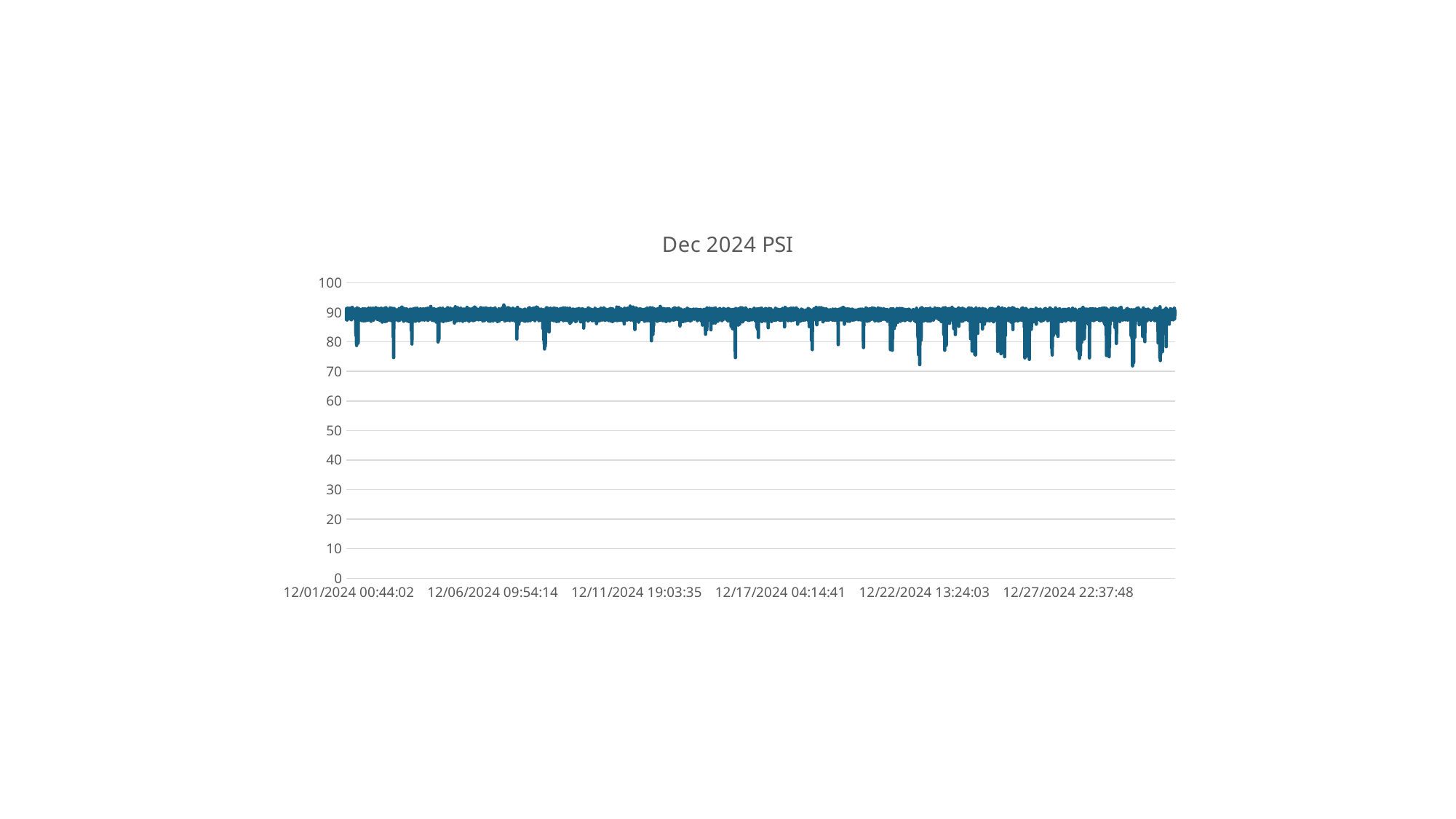
What colour is the plotted line? blue Does the overall level of the line rise sharply, fall sharply, or stay roughly flat across December? stay roughly flat What is the title of the chart? Dec 2024 PSI Around which y-axis gridline do most of the plotted values sit? 90 Is the value at 12/01/2024 00:44:02 greater or less than 50? greater How many date labels are shown along the x axis? 6 How many lines (series) are plotted on the chart? 1 Is the highest value plotted on the chart greater or less than 100? less Do the values on the chart ever drop below 50? No What kind of chart is shown on the slide? line chart